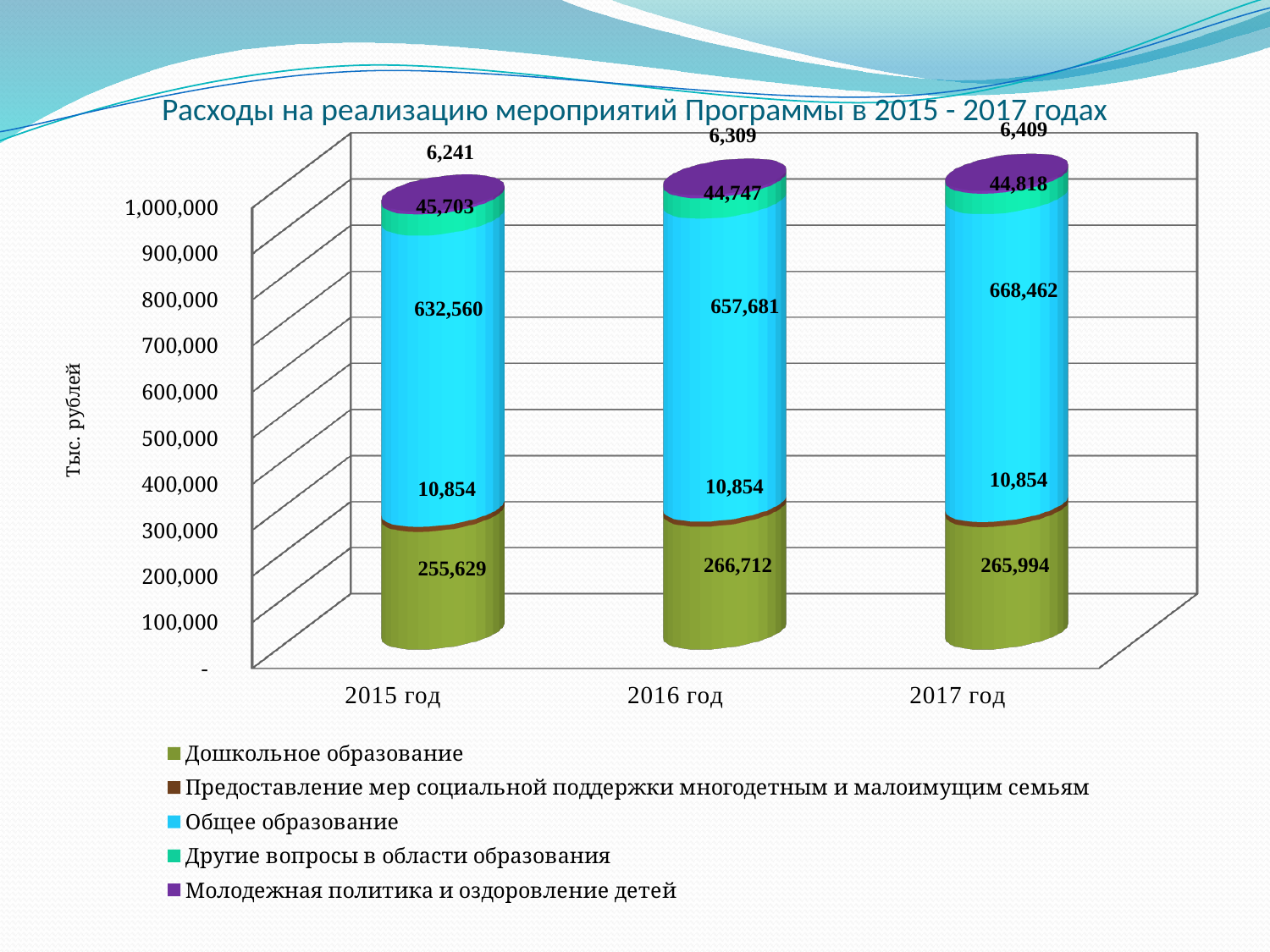
Which is larger: Дошкольное образование in 2016 год or in 2017 год? 2016 год In which year is the value for Дошкольное образование the lowest? 2015 год What is the total of the stacked bar for 2015 год? 950,987 What is the value for Молодежная политика и оздоровление детей in 2017 год? 6,409 How many series does the legend list? 5 What type of chart is shown on the slide? Stacked bar chart In which year is the value for Общее образование the highest? 2017 год What is the value for Дошкольное образование in 2015 год? 255,629 How many categories (years) are shown on the x axis? 3 What is the value for Общее образование in 2016 год? 657,681 What is the value for Другие вопросы в области образования in 2016 год? 44,747 What is the difference between the Общее образование values for 2017 год and 2015 год? 35,902